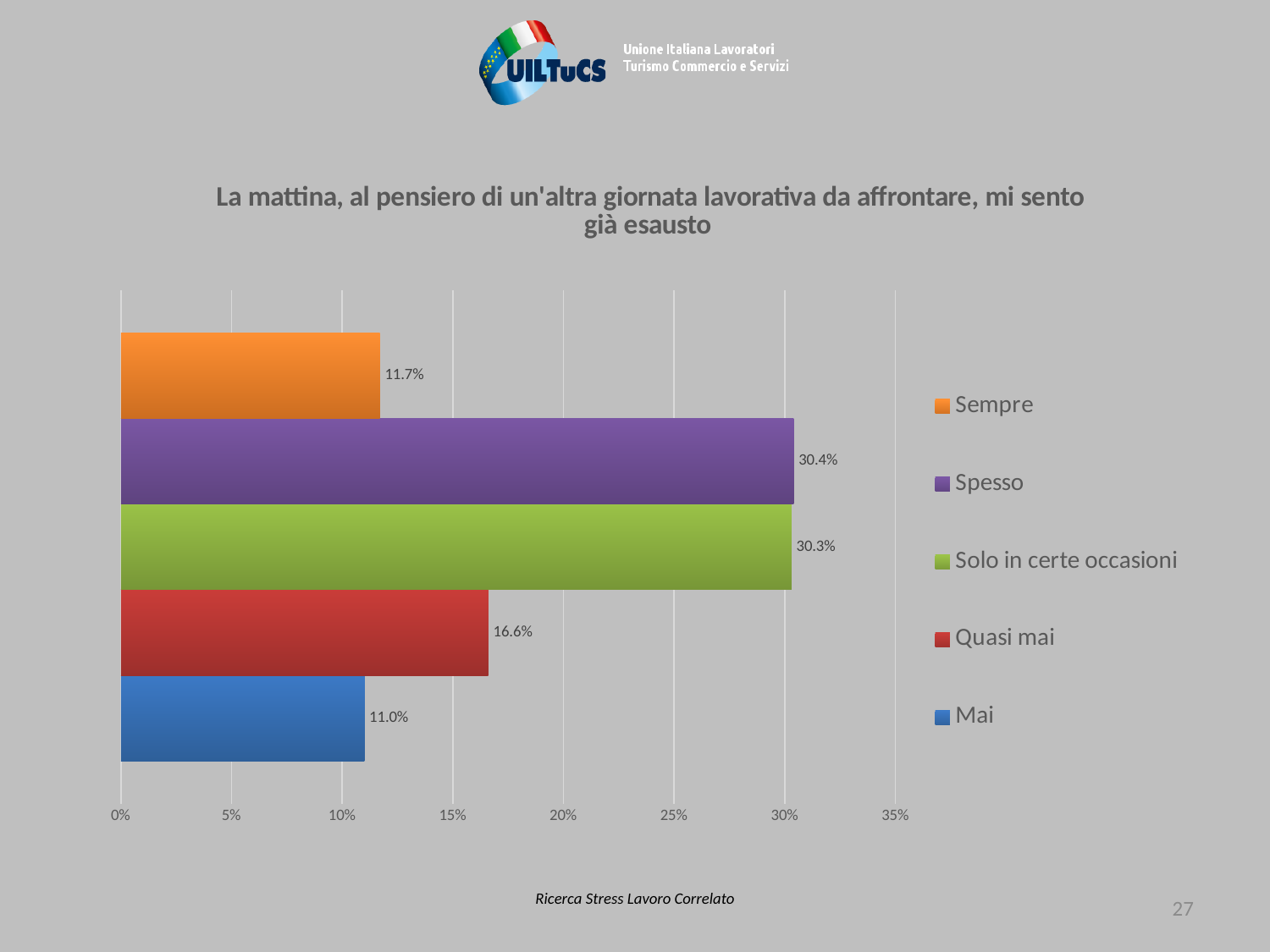
What is the value for Quasi mai? 16.6% Which is larger, the value for Quasi mai or the value for Mai? Quasi mai What kind of chart is shown on the slide? bar chart How many categories are shown in the chart? 5 What is the value for Spesso? 30.4% Which is larger, the value for Spesso or the value for Quasi mai? Spesso What is the value for Mai? 11.0% What is the value for Sempre? 11.7% What is the value for Solo in certe occasioni? 30.3% Is the value for Quasi mai greater or less than 15%? greater What is the difference between the values for Quasi mai and Mai? 5.6 percentage points What is the difference between the values for Spesso and Sempre? 18.7 percentage points